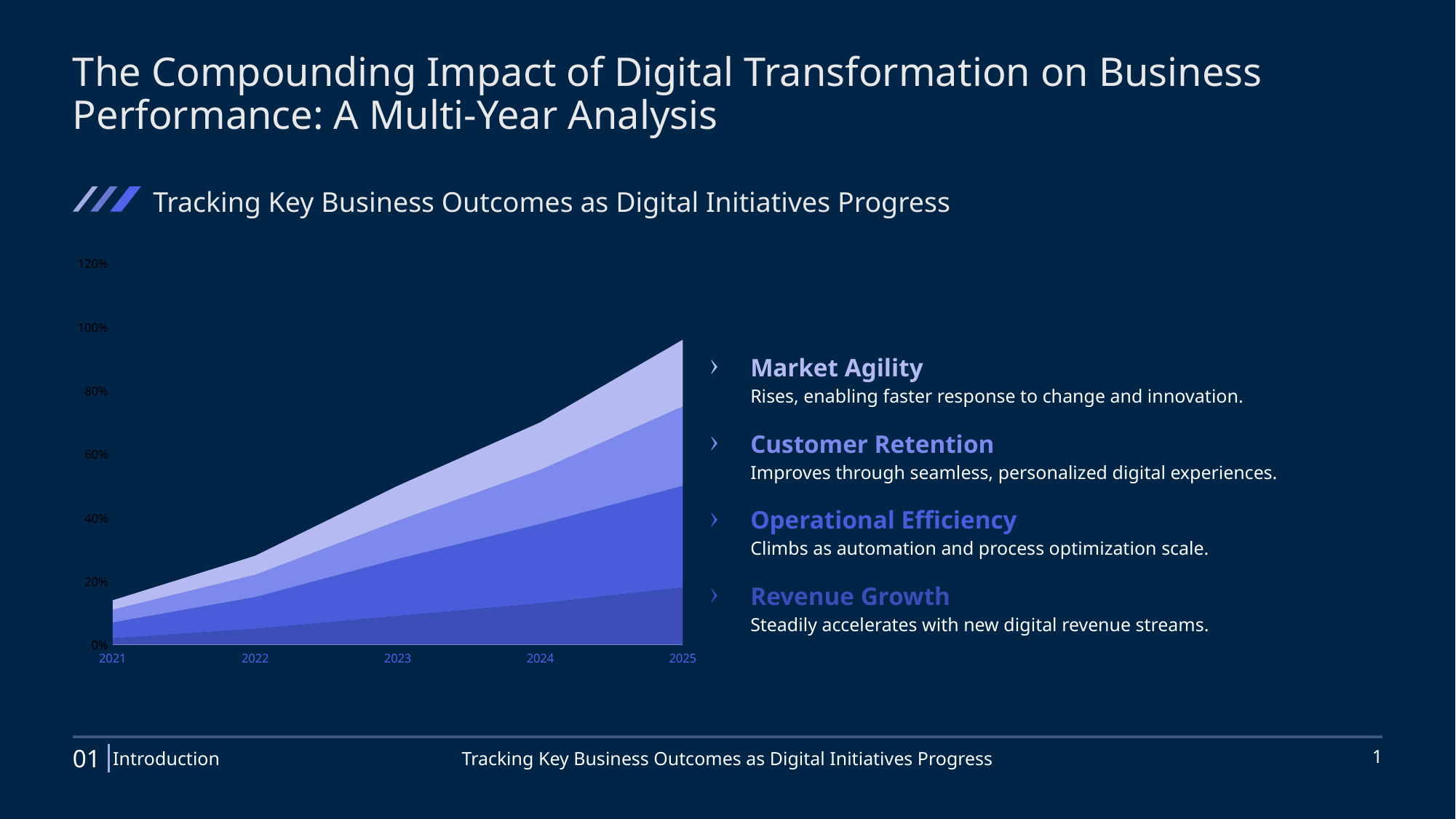
How many stacked bands (series) are plotted in the chart? 4 Is the total stacked value for 2024 greater or less than 80%? less What is the highest value labelled on the chart's y axis? 120% Is the total stacked value for 2022 greater or less than 40%? less Is the total stacked value for 2021 greater or less than 20%? less Does the total stacked value rise or fall from 2021 to 2025? Rises Which year has the highest total stacked value? 2025 How many years are shown along the x axis of the chart? 5 What kind of chart is shown on the slide? Stacked area chart Which year has the lowest total stacked value? 2021